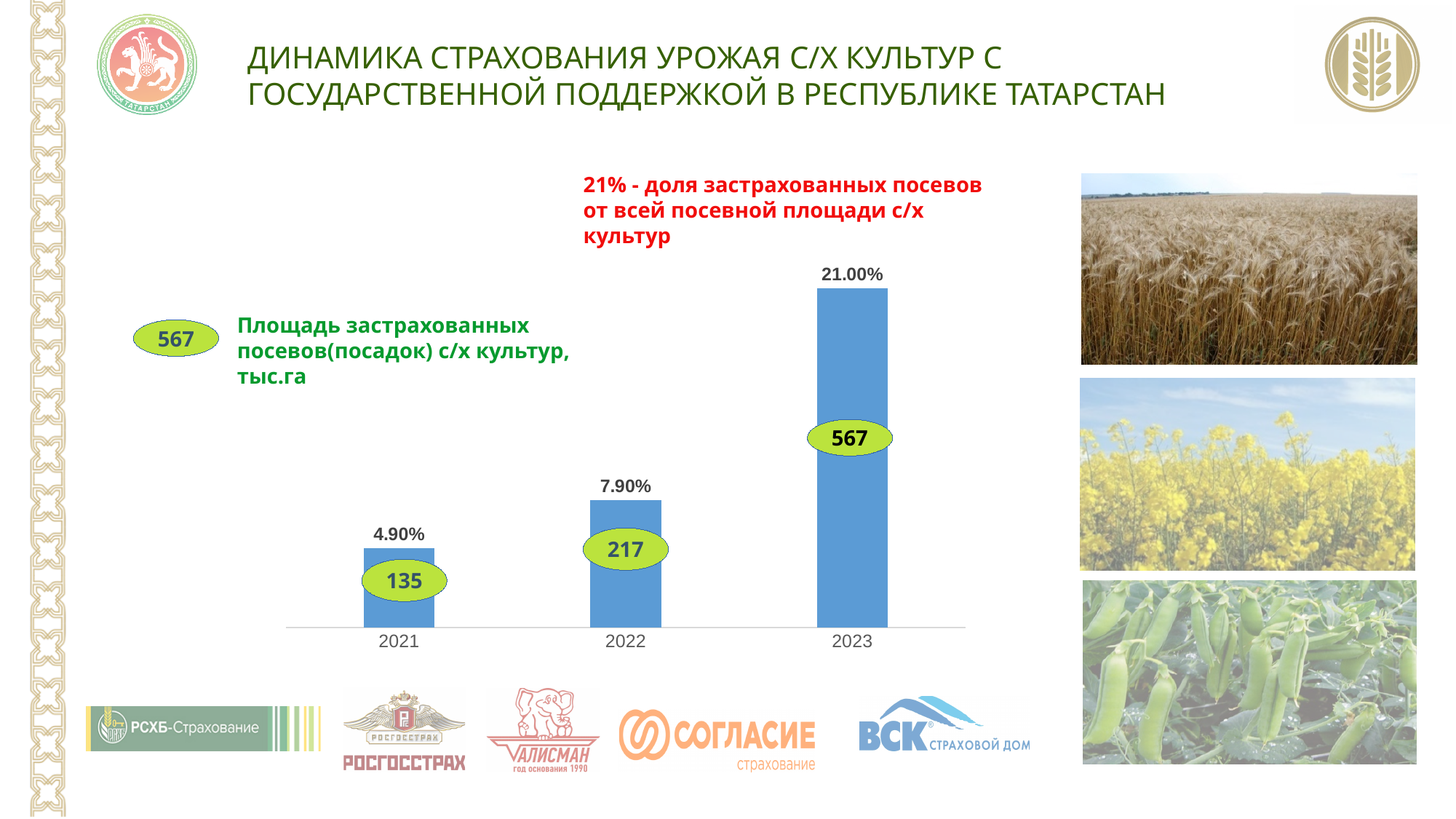
What is the insured crop area (thousand ha) shown in the green oval for 2022? 217 What is the share of insured crops shown for 2022? 7.90% What is the share of insured crops shown for 2021? 4.90% What is the difference in insured area (thousand ha) between 2023 and 2021? 432 Do the values rise or fall from 2021 to 2023? rise By how many percentage points does the 2023 share exceed the 2022 share? 13.10% What is the share of insured crops shown for 2023? 21.00% Which year has the highest share of insured crops? 2023 Which year has a larger insured area, 2021 or 2022? 2022 Which year has the lowest share of insured crops? 2021 What is the insured crop area (thousand ha) shown in the green oval for 2021? 135 How many years are shown on the x axis of the chart? 3